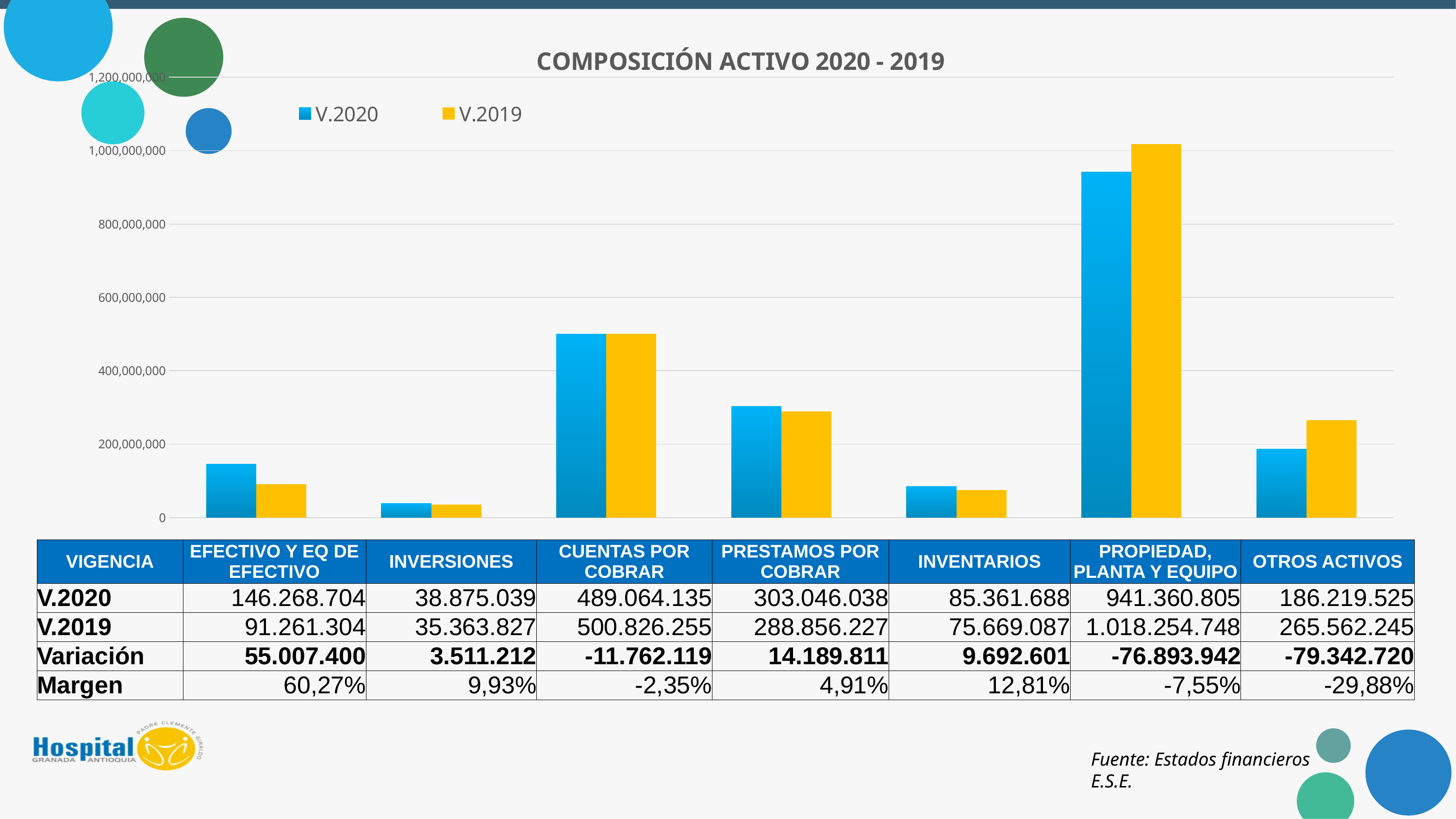
What is the difference between the V.2020 and V.2019 values for EFECTIVO Y EQ DE EFECTIVO? 55.007.400 For OTROS ACTIVOS, which is larger: the V.2020 value or the V.2019 value? V.2019 What is the V.2020 value for PROPIEDAD, PLANTA Y EQUIPO? 941.360.805 Which category has the lowest V.2020 value? INVERSIONES How many categories are plotted on the x axis of the chart? 7 How many series does the chart legend list? 2 What is the V.2019 value for CUENTAS POR COBRAR? 500.826.255 What kind of chart is shown on the slide? bar chart Is the V.2019 value for PROPIEDAD, PLANTA Y EQUIPO greater or less than 1,000,000,000? greater What is the title of the chart? COMPOSICIÓN ACTIVO 2020 - 2019 Which colour represents the V.2019 series in the chart? yellow Which category has the highest V.2019 value? PROPIEDAD, PLANTA Y EQUIPO